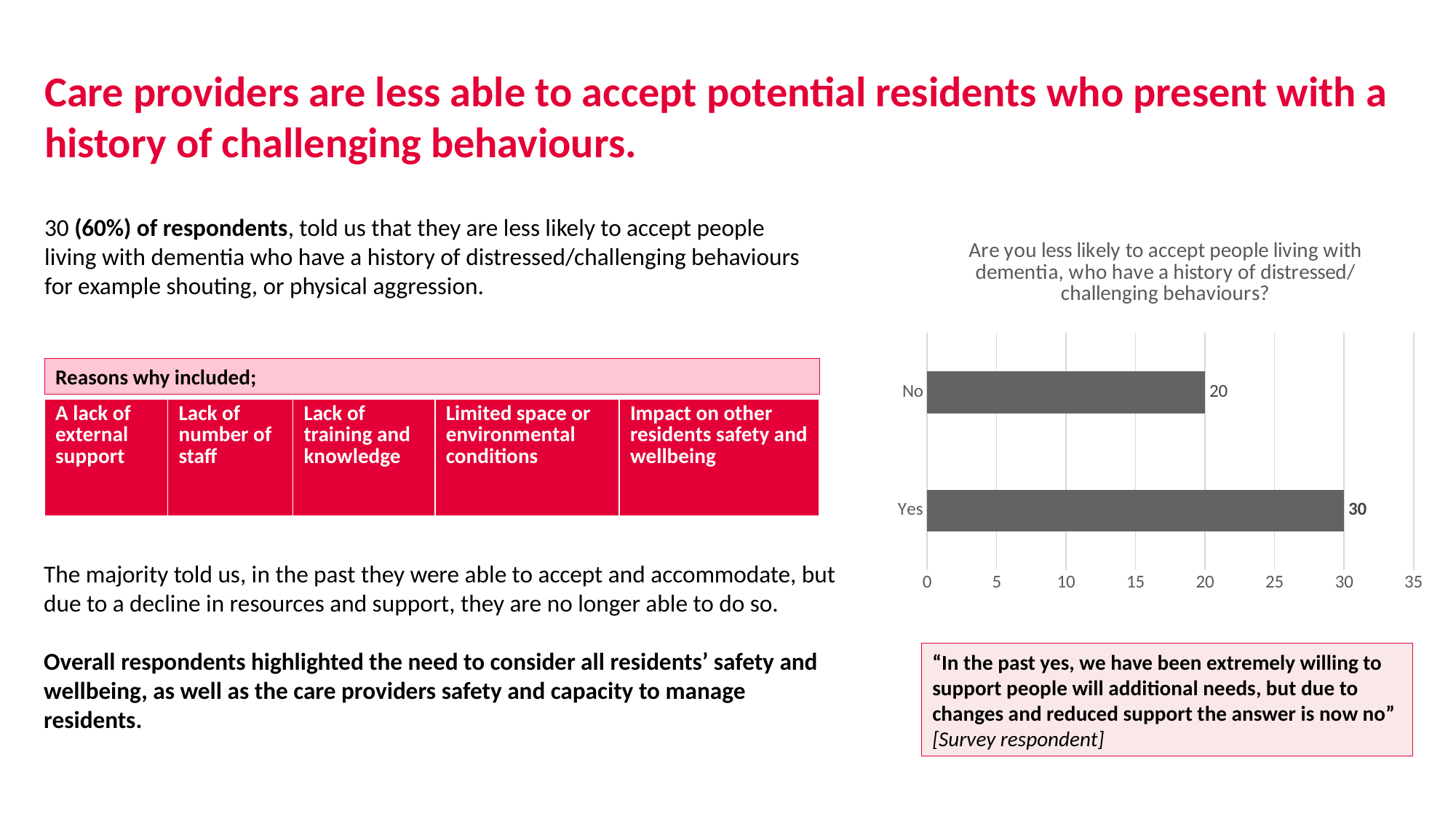
Which category has the highest value in the chart? Yes How many categories are shown in the chart? 2 What is the title of the chart? Are you less likely to accept people living with dementia, who have a history of distressed/ challenging behaviours? What is the value for "Yes" in the chart? 30 What is the difference between the values for "Yes" and "No"? 10 What kind of chart is shown on the slide? Bar chart What is the value for "No" in the chart? 20 What is the total of the two values shown in the chart? 50 Is the value for "No" greater or less than 25? less Which category has the lowest value in the chart? No Which is larger, the value for "Yes" or the value for "No"? Yes What is the highest value shown on the chart's x axis? 35